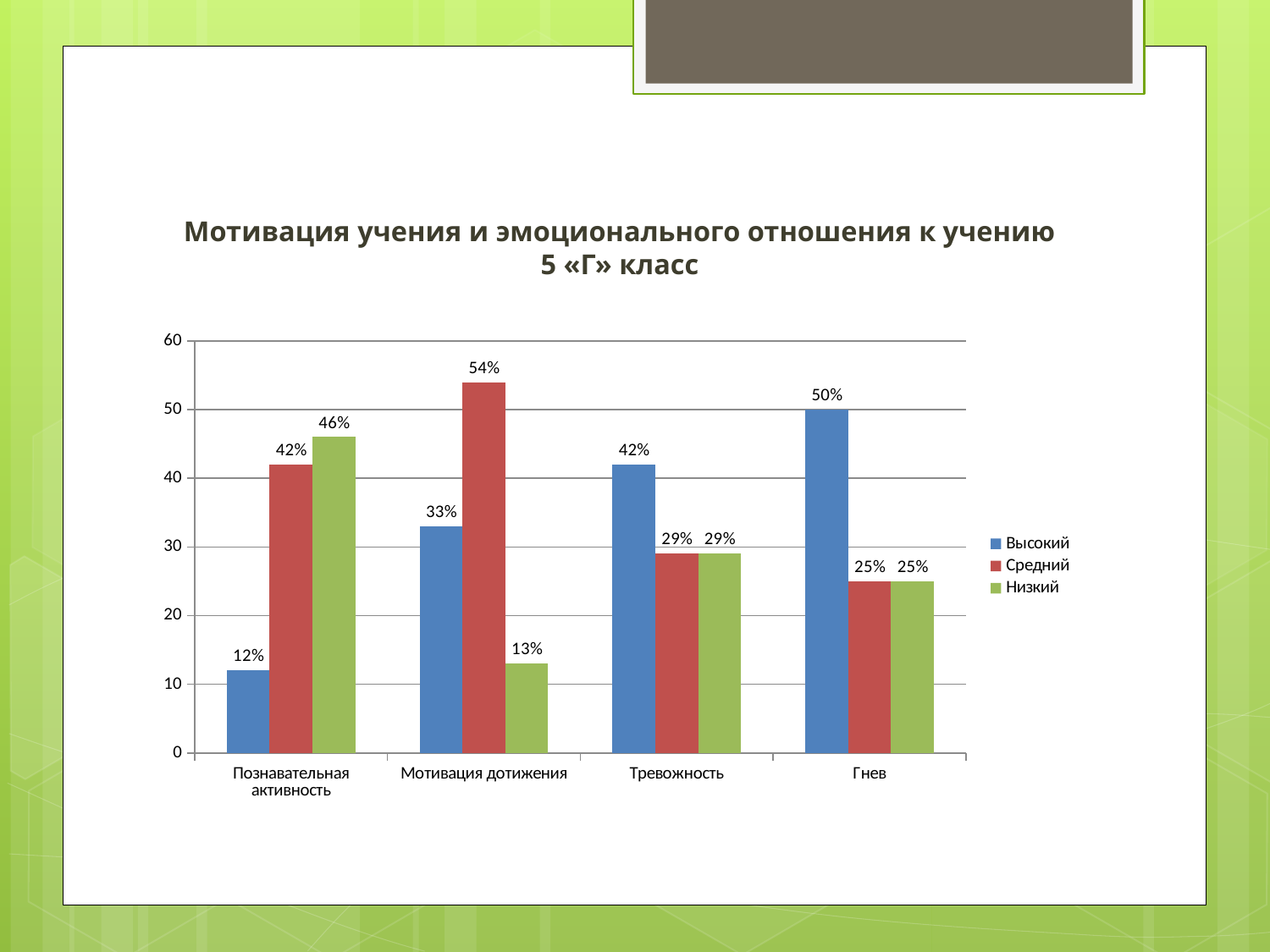
How many series does the legend list? 3 Which category has the highest value in the Высокий series? Гнев What kind of chart is shown on the slide? Bar chart What is the difference between the Средний and Низкий values for Мотивация дотижения? 41% Does the Высокий series rise or fall from Познавательная активность to Гнев? Rises Which category has the lowest value in the Низкий series? Мотивация дотижения What is the value of the Высокий series for Познавательная активность? 12% What is the value of the Средний series for Мотивация дотижения? 54% How many categories are shown on the x axis? 4 What colour represents the Средний series? Red Which is larger for Тревожность: the Высокий value or the Средний value? Высокий What is the value of the Низкий series for Гнев? 25%